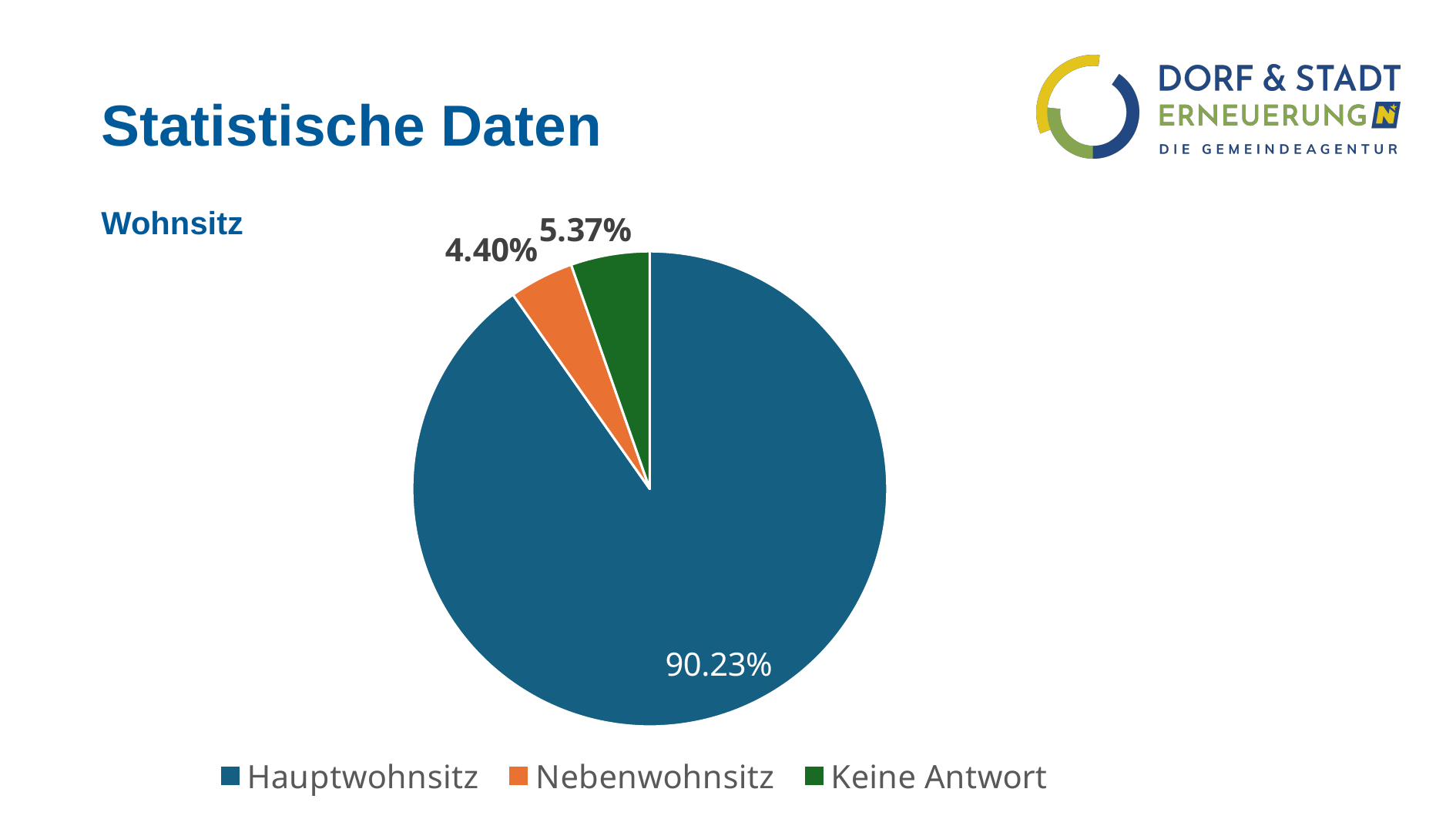
Which category has the smallest slice of the pie? Nebenwohnsitz Which category has the largest slice of the pie? Hauptwohnsitz What is the difference in percentage points between the Keine Antwort slice and the Nebenwohnsitz slice? 0.97 How many categories does the pie chart show? 3 What is the title of the chart? Wohnsitz What share of the pie does Keine Antwort have? 5.37% Which is larger, the slice for Nebenwohnsitz or the slice for Keine Antwort? Keine Antwort What share of the pie does Nebenwohnsitz have? 4.40% Which colour represents Nebenwohnsitz in the legend? Orange What kind of chart is shown on the slide? Pie chart What share of the pie does Hauptwohnsitz have? 90.23% What is the difference in percentage points between the Hauptwohnsitz slice and the Keine Antwort slice? 84.86